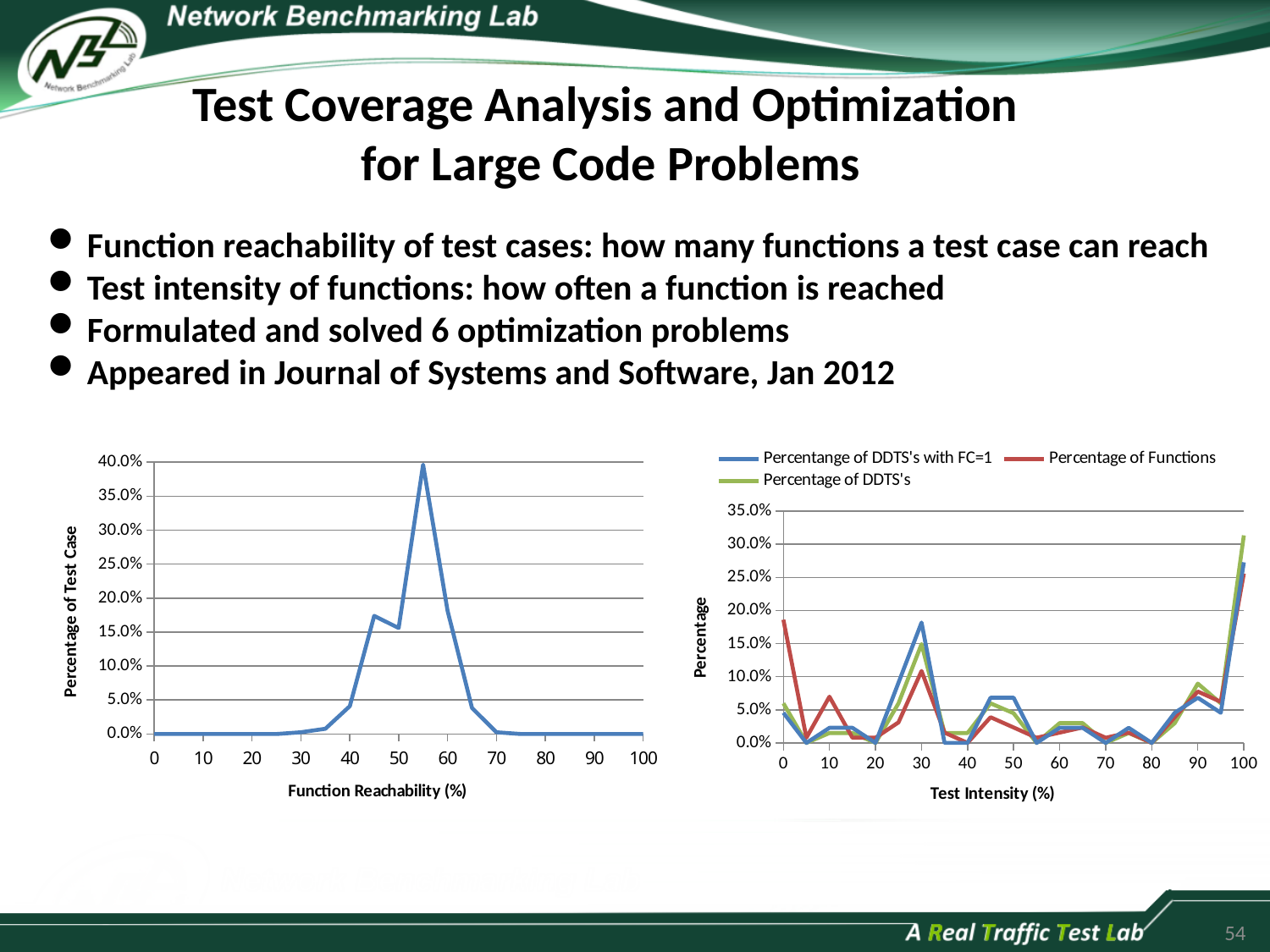
How many series does the legend of the right chart (Test Intensity) list? 3 What kind of chart is the left chart (Function Reachability)? line chart What is the y-axis title of the left chart? Percentage of Test Case In the right chart (Test Intensity), which series has the highest value at Test Intensity 100? Percentage of DDTS's In the left chart (Function Reachability), is the value at Function Reachability 45 greater or less than 15.0%? greater What is the x-axis title of the right chart? Test Intensity (%) In the left chart (Function Reachability), is the value at Function Reachability 65 greater or less than 10.0%? less In the left chart (Function Reachability), at which Function Reachability value does the Percentage of Test Case reach its highest point? 55 In the right chart (Test Intensity), which series has the highest value at Test Intensity 0? Percentage of Functions In the left chart (Function Reachability), is the value at Function Reachability 55 greater or less than 35.0%? greater